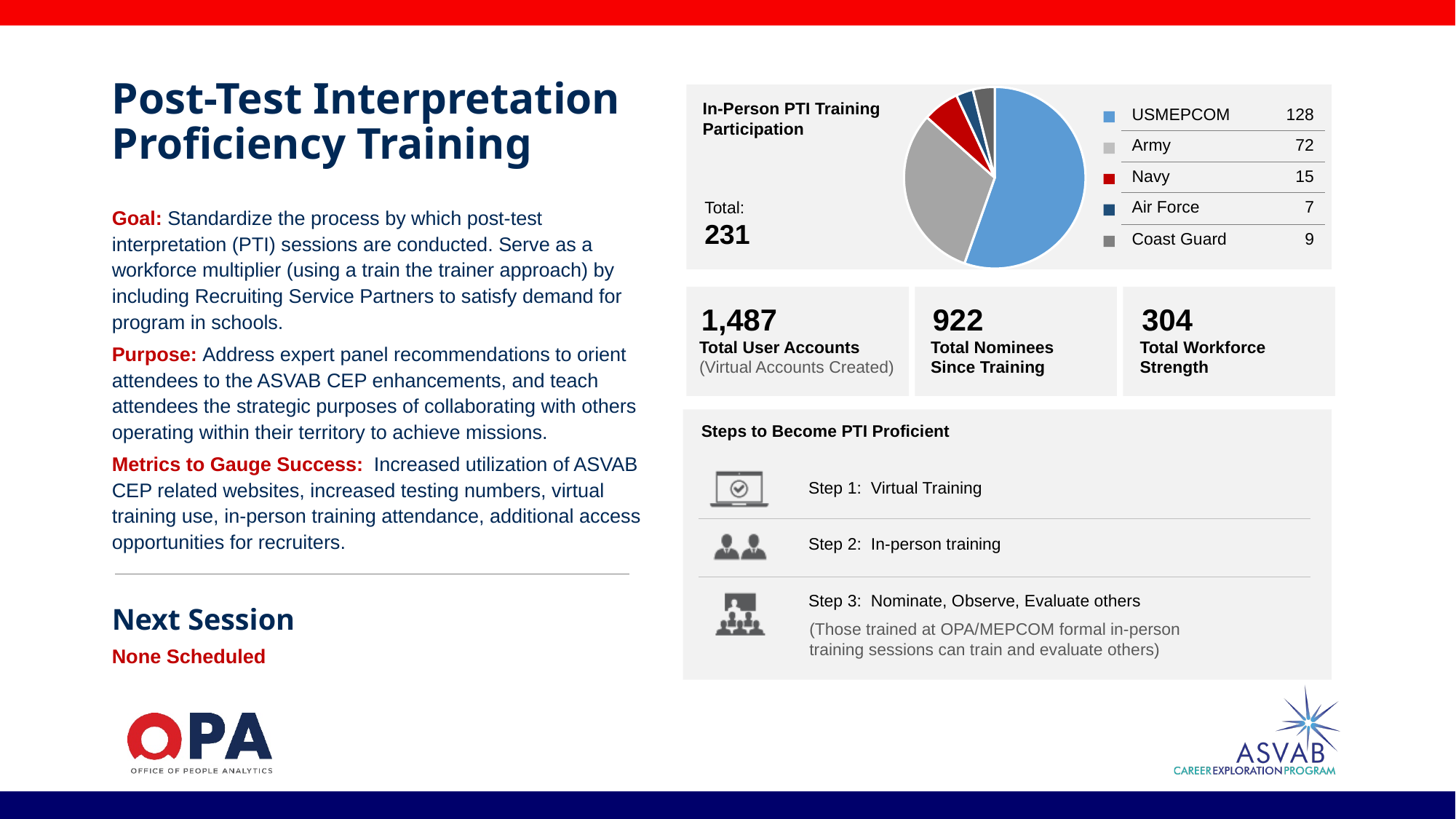
In the In-Person PTI Training Participation chart, what is the value for Army? 72 What type of chart is used to show In-Person PTI Training Participation? Pie chart In the In-Person PTI Training Participation chart, which is larger, Coast Guard or Air Force? Coast Guard In the In-Person PTI Training Participation chart, what is the value for Air Force? 7 What is the total participation shown for the In-Person PTI Training Participation chart? 231 In the In-Person PTI Training Participation chart, how many participants are from USMEPCOM? 128 Which category has the smallest slice in the In-Person PTI Training Participation pie chart? Air Force Which category has the largest slice in the In-Person PTI Training Participation pie chart? USMEPCOM In the In-Person PTI Training Participation chart, what is the difference between the Navy and Coast Guard values? 6 What colour is the USMEPCOM slice in the In-Person PTI Training Participation pie chart? Blue How many categories are shown in the In-Person PTI Training Participation pie chart? 5 In the In-Person PTI Training Participation chart, how much larger is the USMEPCOM value than the Army value? 56